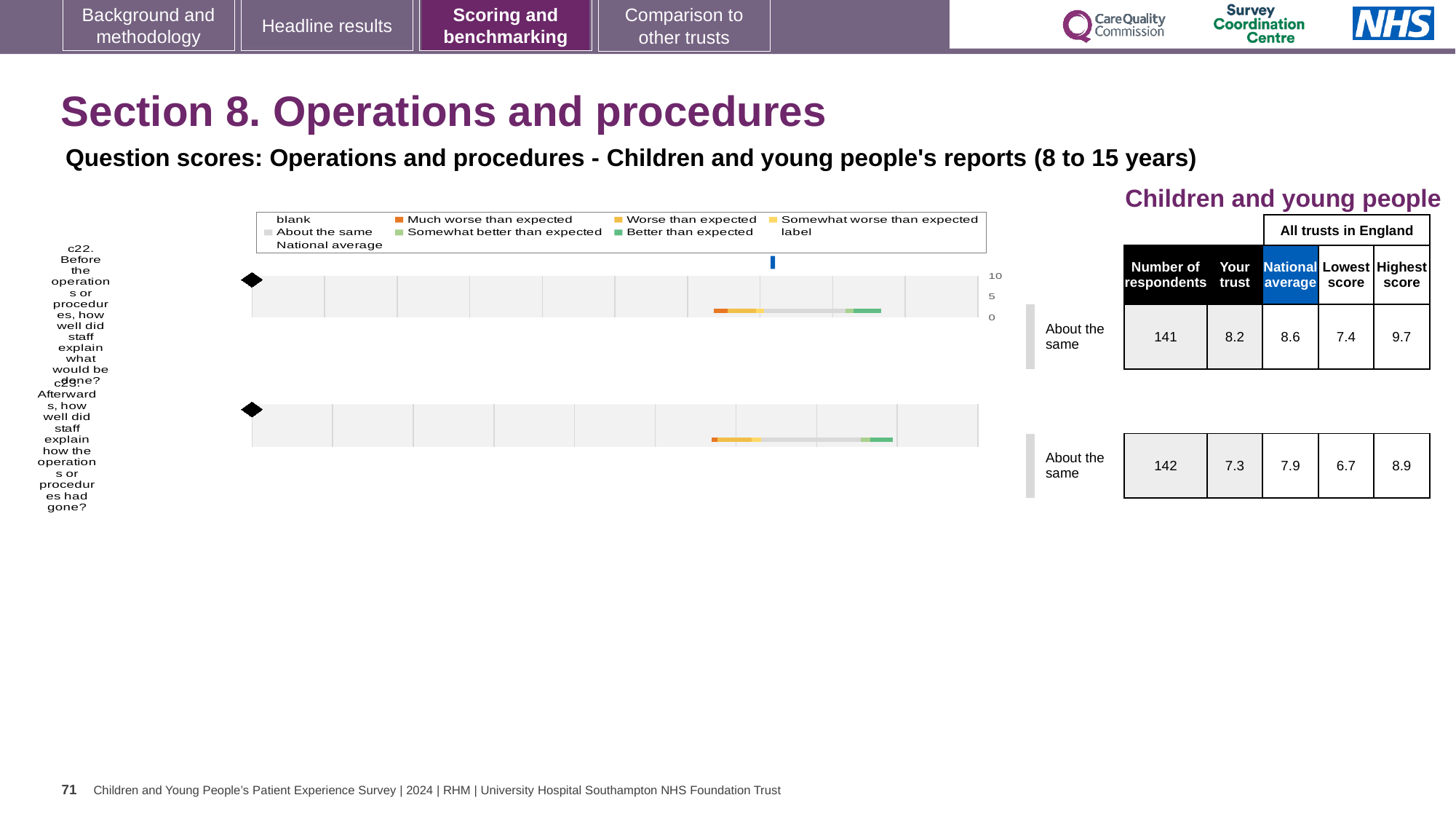
What is the national average score for question c22? 8.6 How many questions are plotted on the slide? 2 How many respondents answered question c23 (Afterwards, how well did staff explain how the operations or procedures had gone?)? 142 What is the difference between the national average and the 'Your trust' score for question c22? 0.4 Which question has the higher 'Your trust' score, c22 or c23? c22 What is the highest score among all trusts in England for question c22? 9.7 What is the lowest score among all trusts in England for question c22? 7.4 What benchmark category is shown for question c23? About the same What kind of chart is used to show the question scores on this slide? Bar chart What is the 'Your trust' score for question c22 (Before the operations or procedures, how well did staff explain what would be done?)? 8.2 What is the 'Your trust' score for question c23? 7.3 Which colour does the legend use for 'Much worse than expected'? Orange